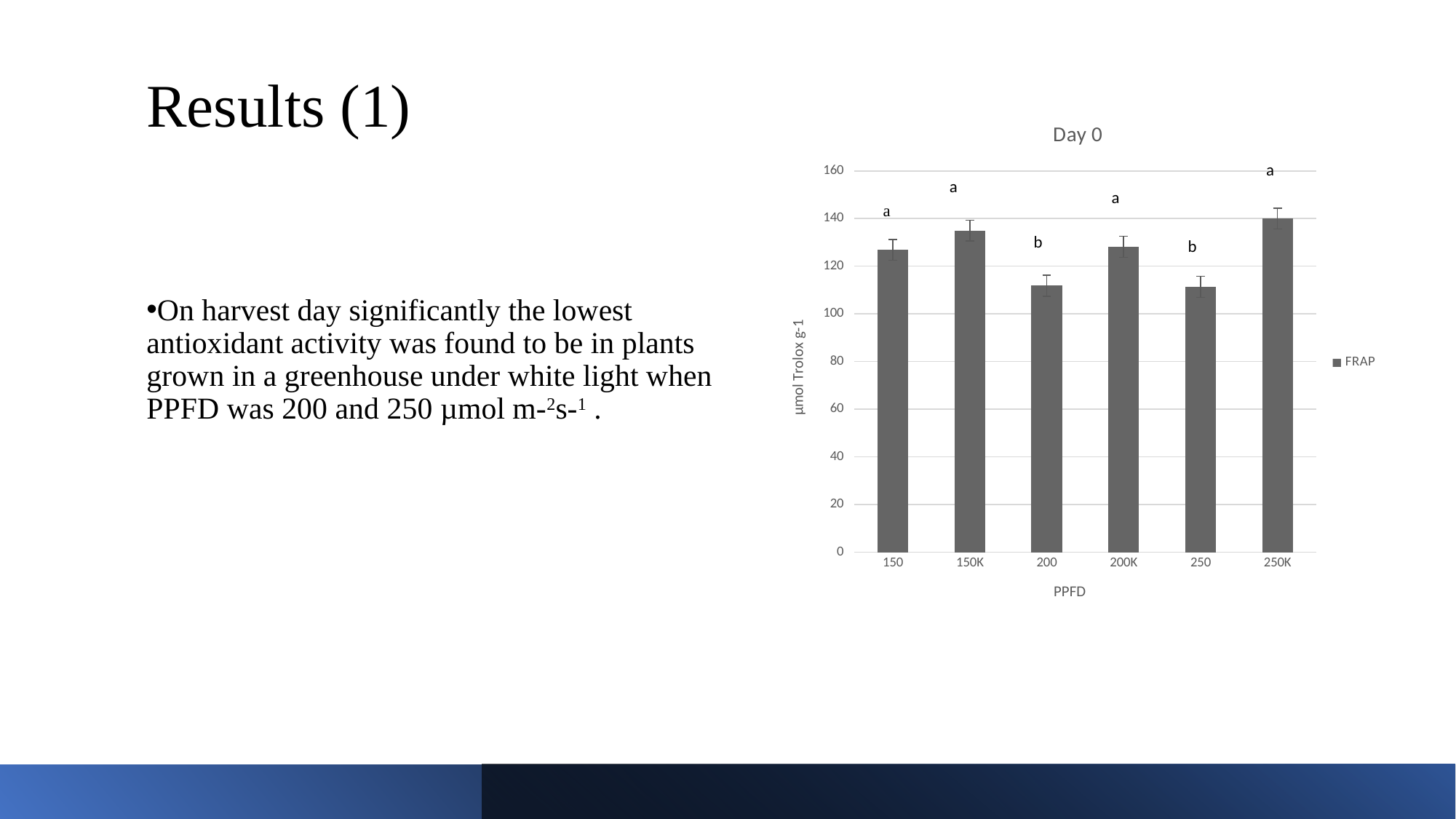
Is the FRAP value for 200 greater or less than 120? less What type of chart is shown on the slide? bar chart What is the title of the chart? Day 0 How many categories are shown on the x axis of the chart? 6 Which PPFD category has the highest FRAP value? 250K Which has a larger FRAP value, 250 or 250K? 250K Is the FRAP value for 150K greater or less than 120? greater Which has a larger FRAP value, 150K or 200? 150K What is the name of the series shown in the chart's legend? FRAP Is the FRAP value for 250K greater or less than 160? less How many series does the chart's legend list? 1